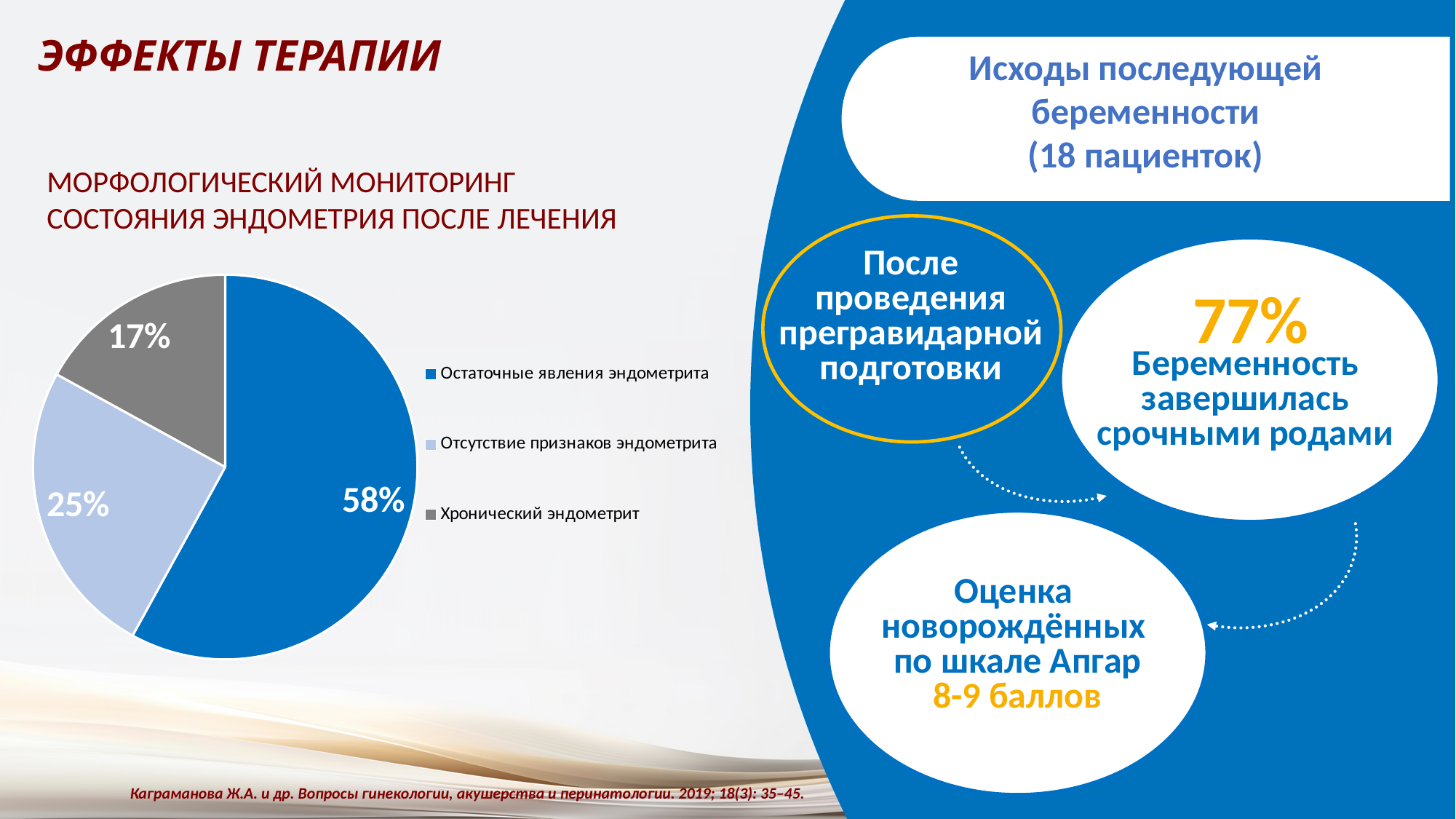
How many categories does the pie chart have? 3 What type of chart is shown on the slide? pie chart Which category has the largest slice of the pie? Остаточные явления эндометрита What is the difference in percentage points between 'Отсутствие признаков эндометрита' and 'Хронический эндометрит'? 8 What share of the pie does 'Хронический эндометрит' have? 17% What is the difference in percentage points between 'Остаточные явления эндометрита' and 'Отсутствие признаков эндометрита'? 33 What share of the pie does 'Отсутствие признаков эндометрита' have? 25% What colour is the slice for 'Хронический эндометрит'? grey Which category has the smallest slice of the pie? Хронический эндометрит Which is larger: the slice for 'Отсутствие признаков эндометрита' or the slice for 'Хронический эндометрит'? Отсутствие признаков эндометрита What share of the pie does 'Остаточные явления эндометрита' have? 58% How many entries does the legend list? 3